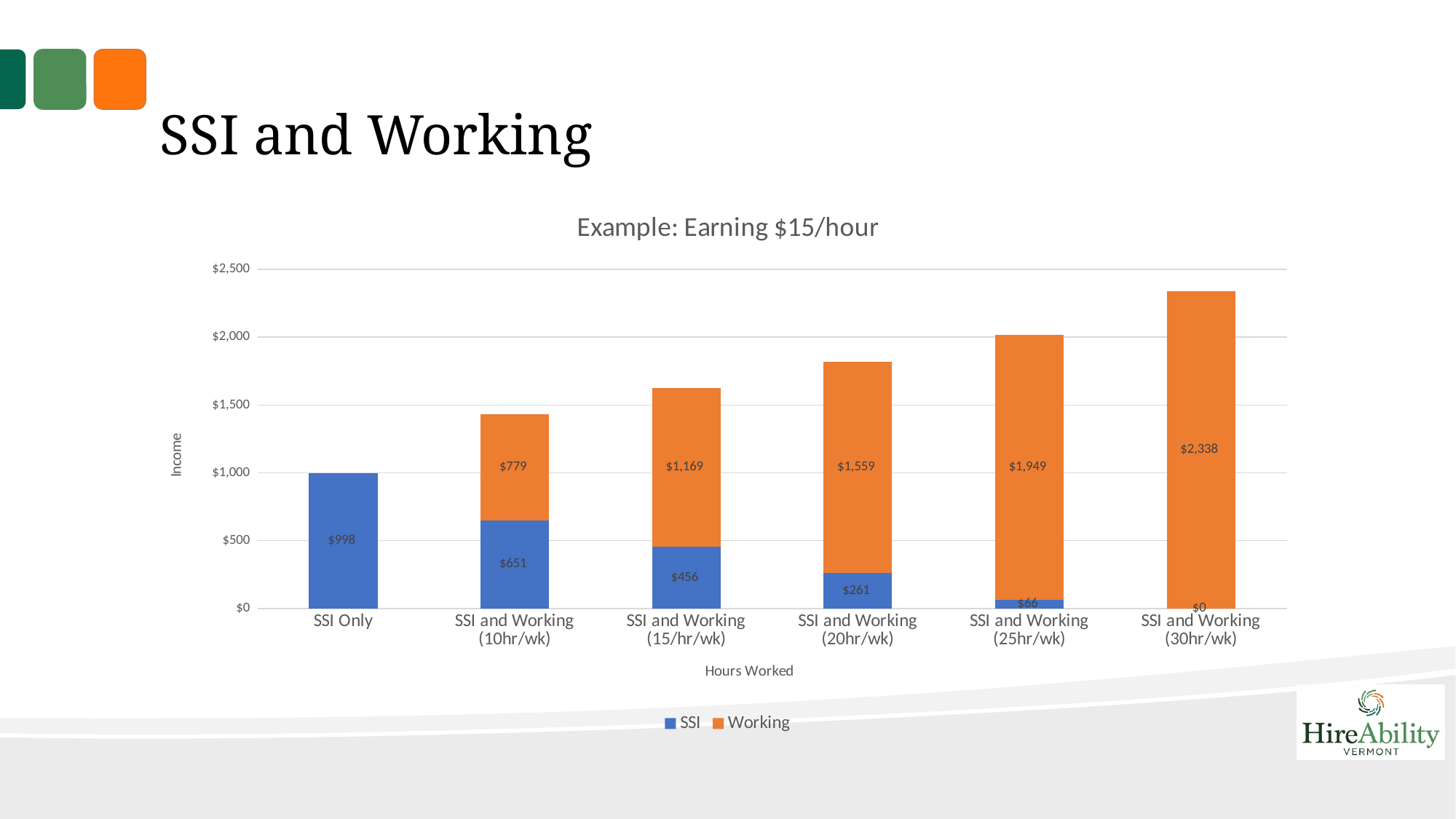
What kind of chart is shown on the slide? Stacked bar chart Which is larger: the SSI value for SSI and Working (10hr/wk) or the SSI value for SSI and Working (20hr/wk)? SSI and Working (10hr/wk) What is the total of the stacked bar for SSI and Working (20hr/wk)? $1,820 What is the Working value for the SSI and Working (20hr/wk) category? $1,559 How many categories are shown on the x axis? 6 What is the difference between the Working values for SSI and Working (25hr/wk) and SSI and Working (10hr/wk)? $1,170 Which category has the lowest SSI value? SSI and Working (30hr/wk) How many series does the legend list? 2 What is the title of the chart? Example: Earning $15/hour What is the SSI value for the SSI and Working (15/hr/wk) category? $456 Which category has the highest Working value? SSI and Working (30hr/wk) What is the SSI value for the SSI Only category? $998